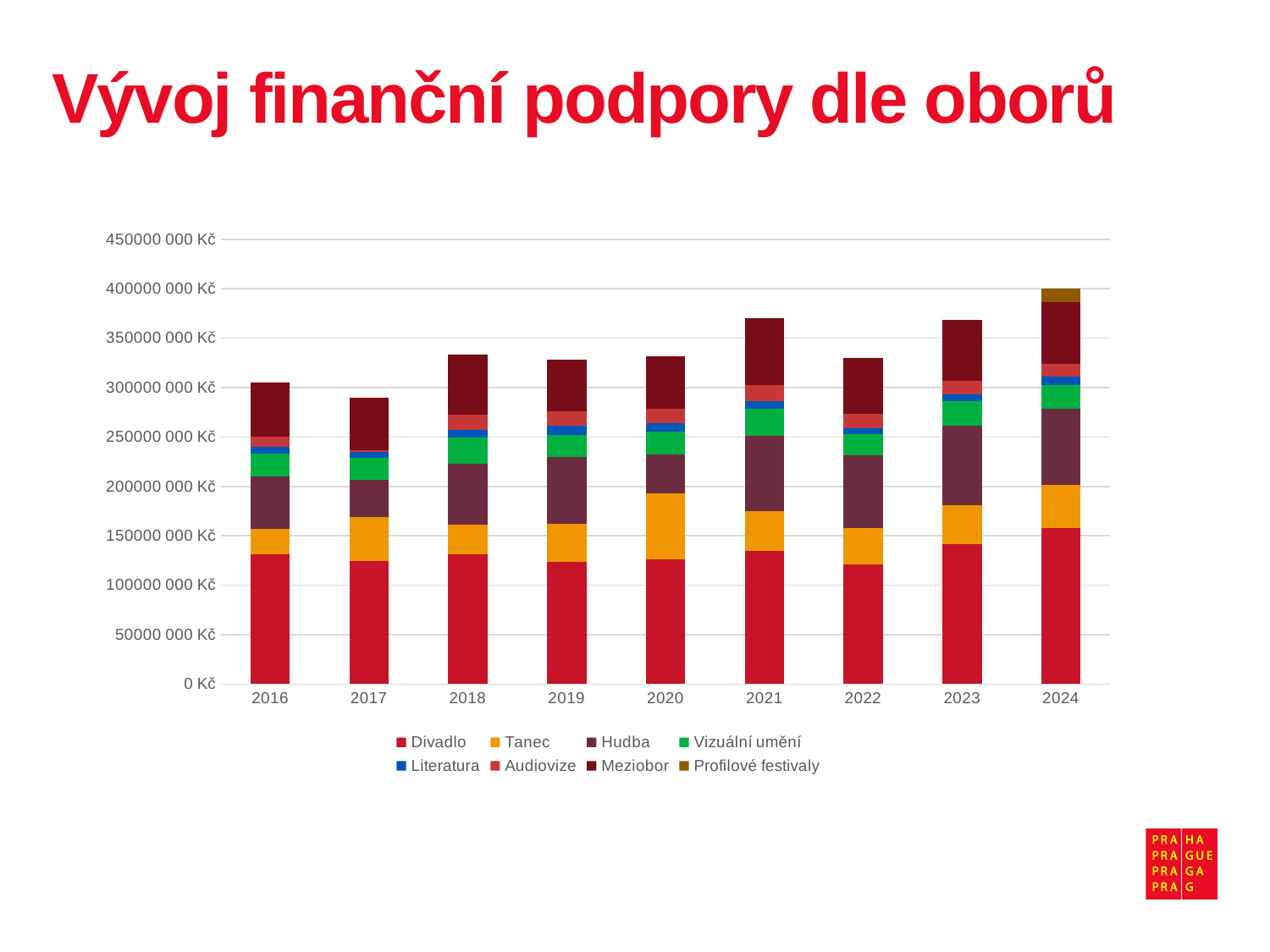
Which year has the highest total stacked bar? 2024 Which year has the lowest total stacked bar? 2017 Which year has the larger total, 2021 or 2022? 2021 Is the Divadlo value for 2017 greater or less than 150000 000 Kč? less How many years are shown on the x axis of the chart? 9 Is the total for 2022 greater or less than 350000 000 Kč? less Is the total for 2024 greater or less than 350000 000 Kč? greater What kind of chart is shown on the slide? stacked bar chart What is the title of the slide? Vývoj finanční podpory dle oborů How many series does the legend list? 8 Which series appears only in the 2024 bar, at the top of the stack? Profilové festivaly